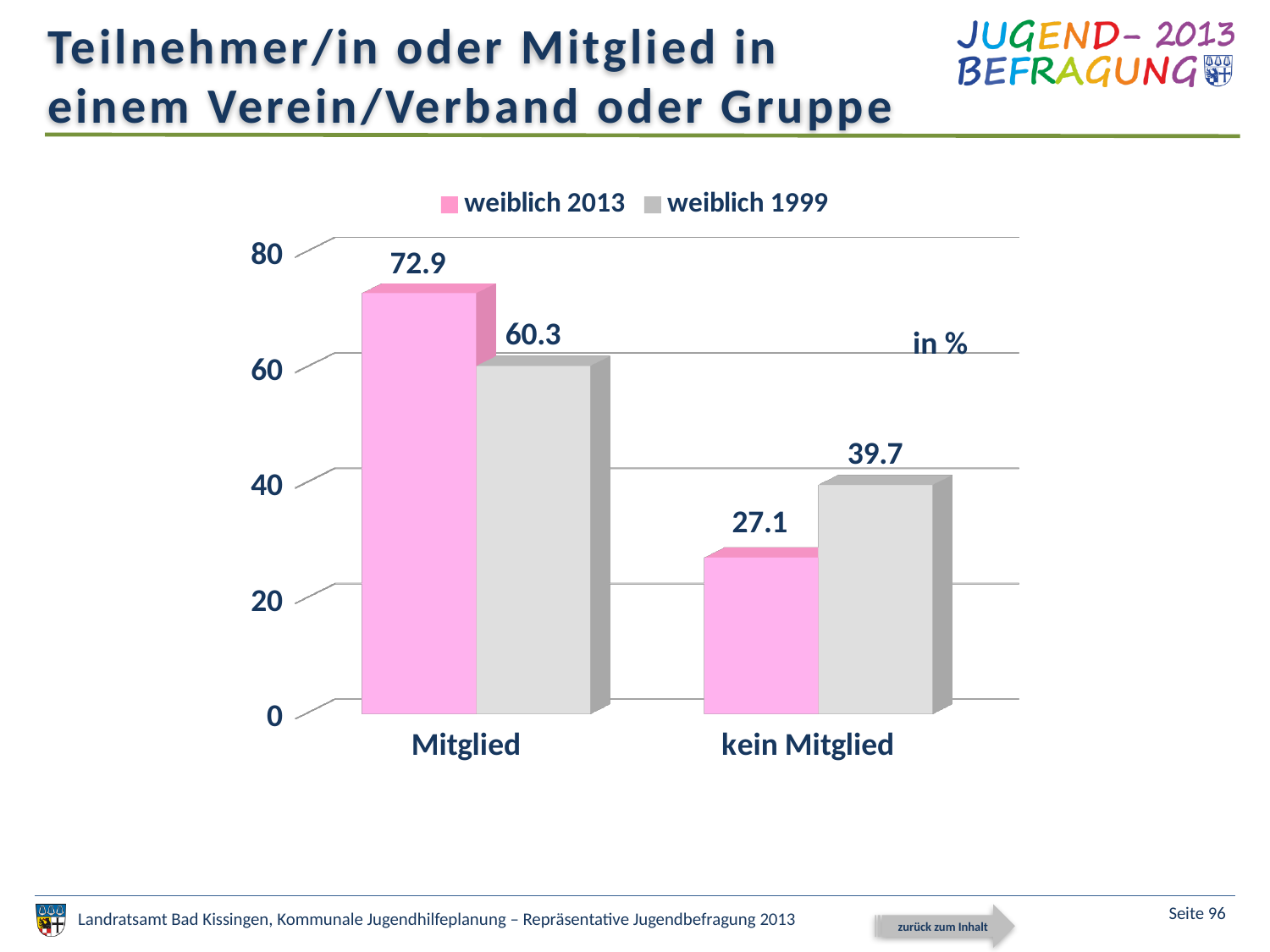
What kind of chart is shown on the slide? Bar chart What is the difference between the 'weiblich 2013' and 'weiblich 1999' values for 'Mitglied'? 12.6 What is the value for 'kein Mitglied' in the 'weiblich 2013' series? 27.1 How many series does the legend list? 2 What is the value for 'Mitglied' in the 'weiblich 2013' series? 72.9 What is the value for 'kein Mitglied' in the 'weiblich 1999' series? 39.7 How many categories are shown on the x axis? 2 Which bar has the highest value in the chart? Mitglied, weiblich 2013 What is the value for 'Mitglied' in the 'weiblich 1999' series? 60.3 Which bar has the lowest value in the chart? kein Mitglied, weiblich 2013 What is the difference between the 'weiblich 1999' and 'weiblich 2013' values for 'kein Mitglied'? 12.6 For 'kein Mitglied', which series has the larger value, 'weiblich 2013' or 'weiblich 1999'? weiblich 1999